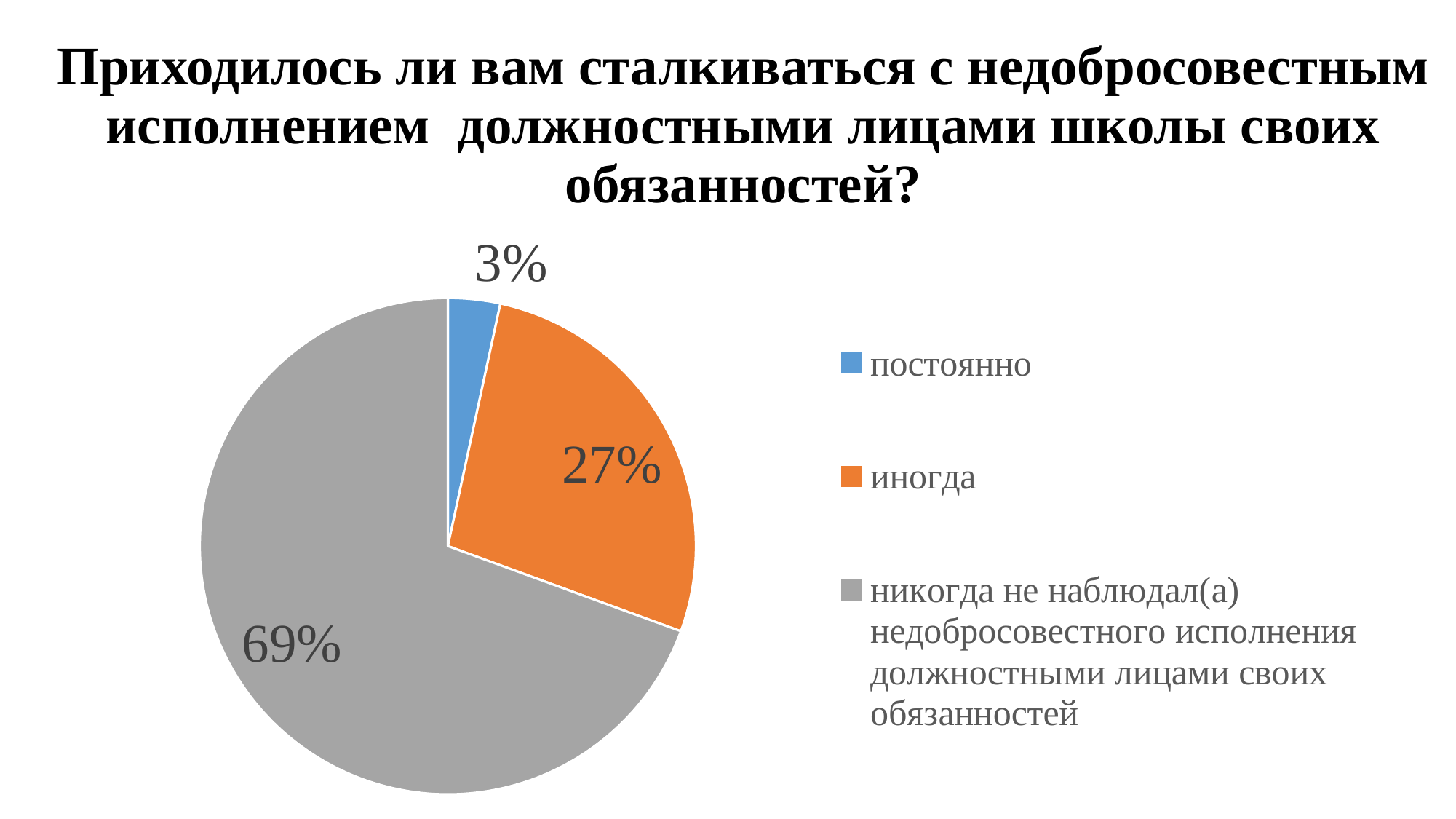
How many entries does the legend list? 3 Which category has the largest share of the pie? никогда не наблюдал(а) недобросовестного исполнения должностными лицами своих обязанностей What percentage of the pie is labelled "иногда"? 27% Which is larger: the share for "иногда" or the share for "постоянно"? иногда What percentage of the pie is labelled "никогда не наблюдал(а) недобросовестного исполнения должностными лицами своих обязанностей"? 69% What colour is the slice for "постоянно"? blue What percentage of the pie is labelled "постоянно"? 3% Which category has the smallest share of the pie? постоянно What type of chart is shown on the slide? pie chart How many slices does the pie chart have? 3 What colour is the slice for "иногда"? orange What is the difference in percentage points between "иногда" and "постоянно"? 24